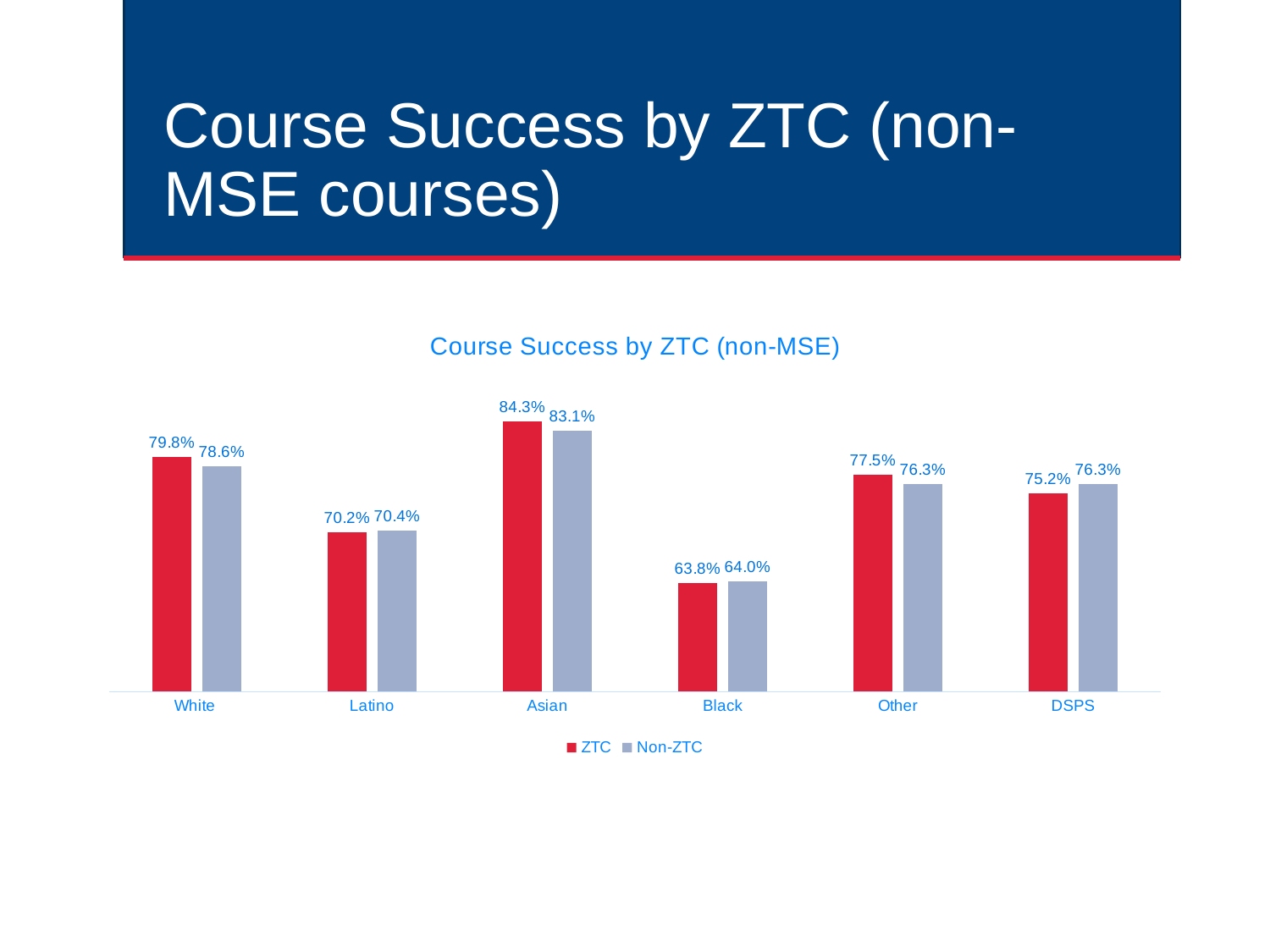
What kind of chart is shown on the slide? Bar chart What is the difference between the ZTC and Non-ZTC course success rates for Asian students? 1.2% How many categories are shown on the x axis of the chart? 6 For Other students, which is larger: the ZTC or the Non-ZTC course success rate? ZTC What is the ZTC course success rate for White students? 79.8% What is the Non-ZTC course success rate for Asian students? 83.1% How many series does the legend list? 2 What is the difference between the ZTC course success rates for White and Latino students? 9.6% Which category has the lowest Non-ZTC course success rate? Black What is the ZTC course success rate for DSPS students? 75.2% Which category has the highest ZTC course success rate? Asian What is the title of the chart? Course Success by ZTC (non-MSE)